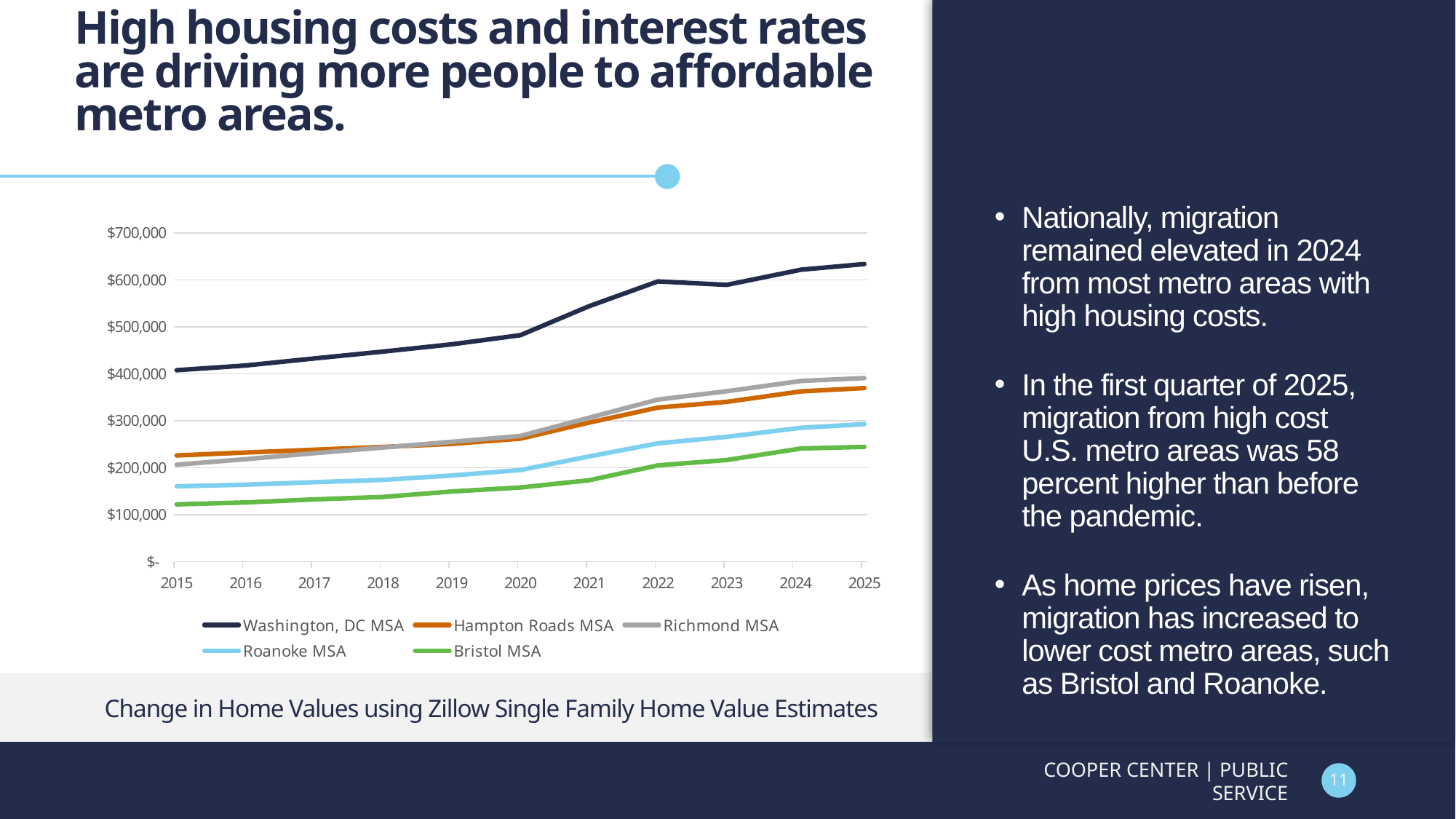
Is the 2025 value for Bristol MSA greater or less than $300,000? less Is the 2025 value for Washington, DC MSA greater or less than $600,000? greater What colour is the line for Bristol MSA in the chart? green Which metro area has the highest home value in 2025? Washington, DC MSA Do home values for Washington, DC MSA rise or fall from 2015 to 2025? rise How many years are shown along the x axis of the chart? 11 Is the 2020 value for Washington, DC MSA greater or less than $500,000? less What kind of chart is shown on the slide? line chart Which metro area has the lowest home value in 2025? Bristol MSA In 2015, which has the higher home value, Hampton Roads MSA or Richmond MSA? Hampton Roads MSA How many series does the chart's legend list? 5